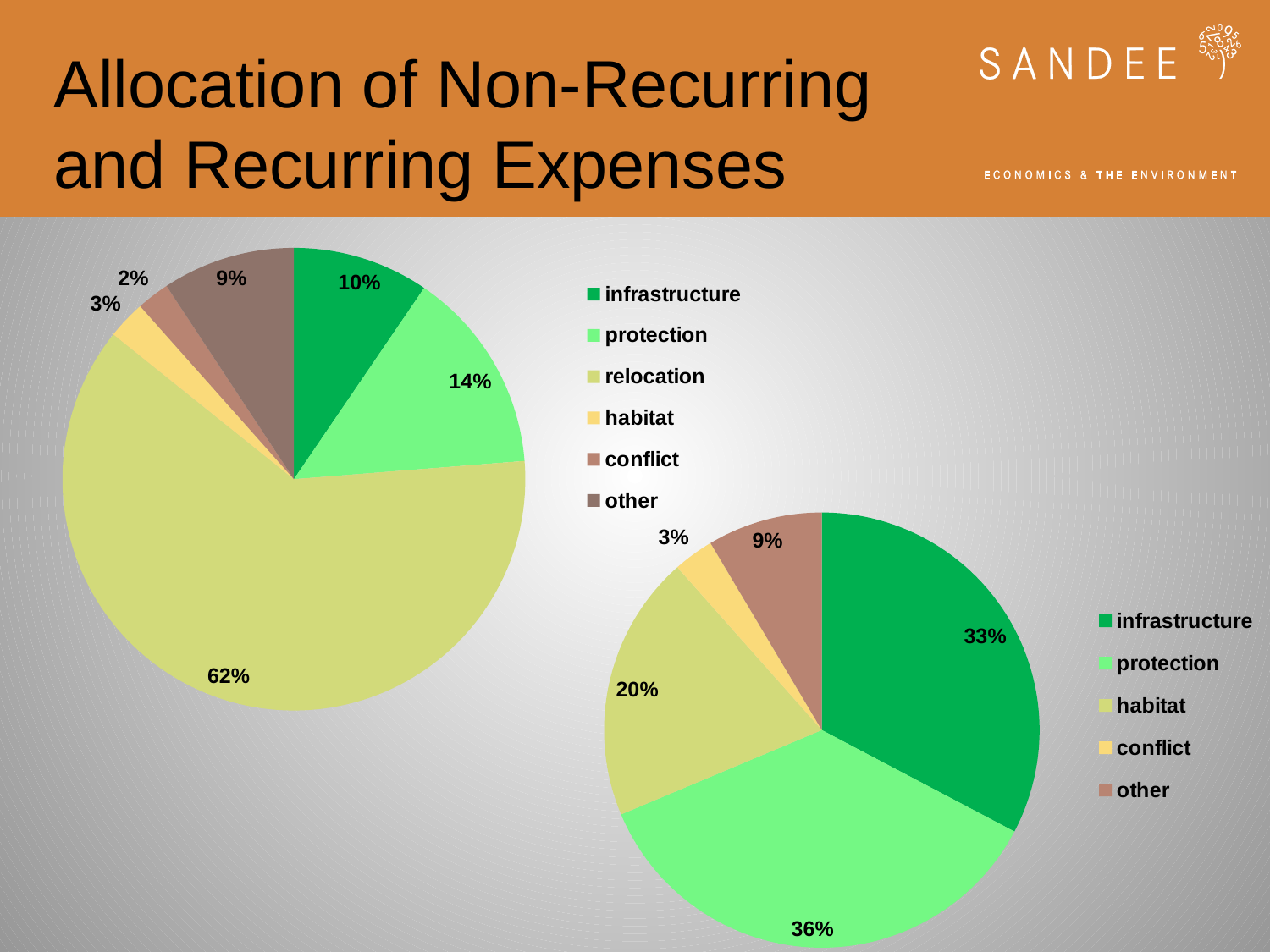
In the left pie chart, which category has the largest share? relocation How many categories does the legend of the left pie chart list? 6 In the right pie chart, which category has the smallest share? conflict In the right pie chart, what share does habitat have? 20% In the left pie chart, which category has the smallest share? conflict In the left pie chart, what share does relocation have? 62% In the right pie chart, what is the difference in percentage points between protection and infrastructure? 3 In the left pie chart, which is larger, the share for infrastructure or the share for other? infrastructure What type of chart is the chart on the right of the slide? pie chart In the right pie chart, what share does infrastructure have? 33% In the left pie chart, what share does protection have? 14% In the right pie chart, which category has the largest share? protection